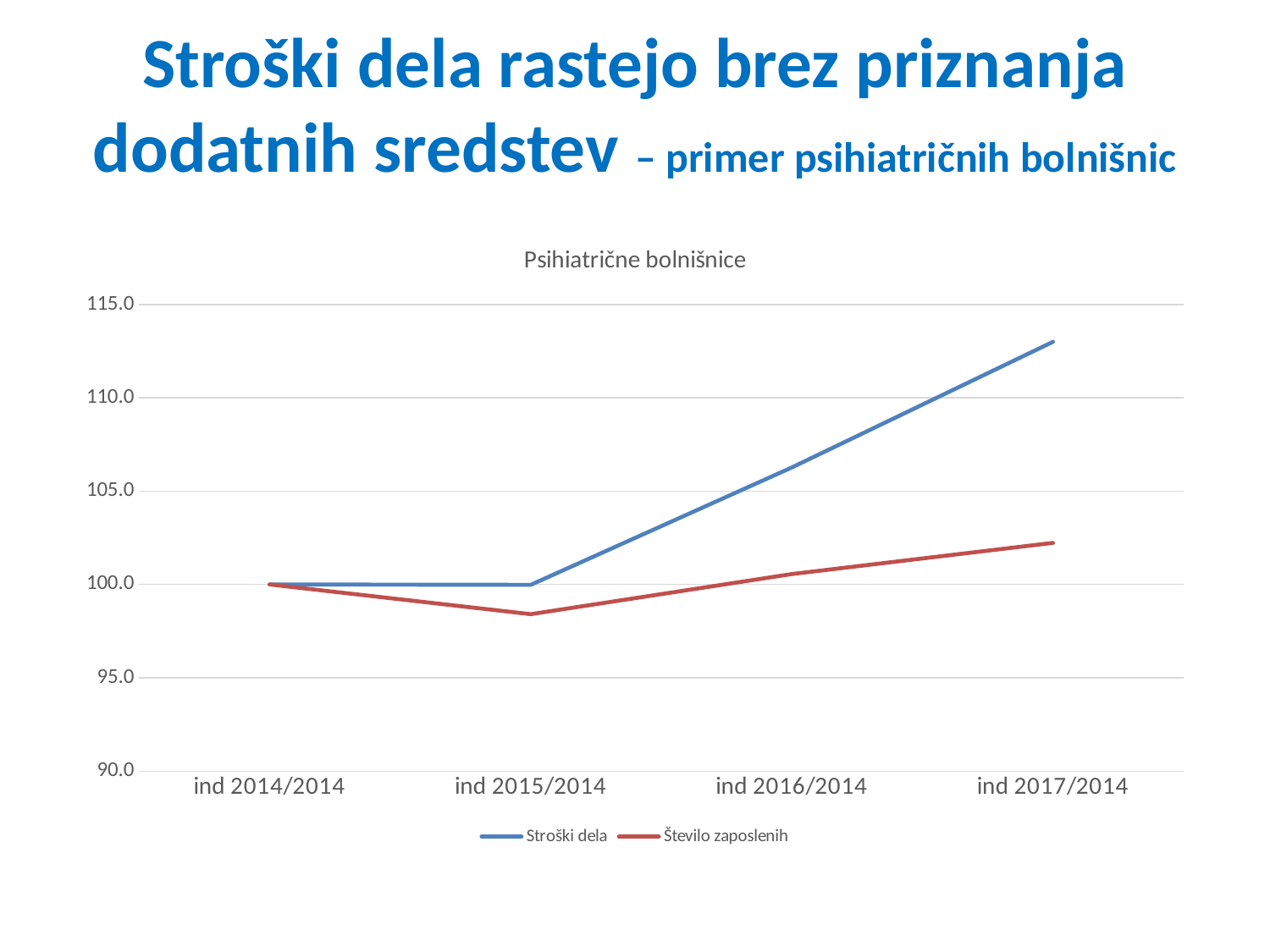
Which series has the higher value at ind 2017/2014, Stroški dela or Število zaposlenih? Stroški dela Is the value of Število zaposlenih at ind 2015/2014 greater or less than 100.0? less At which category does the Stroški dela series reach its highest value? ind 2017/2014 What kind of chart is shown on the slide? line chart How many series does the legend list? 2 Is the value of Število zaposlenih at ind 2017/2014 greater or less than 105.0? less What is the title of the chart? Psihiatrične bolnišnice What is the value of Stroški dela at ind 2014/2014? 100.0 How many categories are shown on the x axis? 4 Does the Stroški dela series rise or fall from ind 2015/2014 to ind 2017/2014? rise Is the value of Stroški dela at ind 2017/2014 greater or less than 110.0? greater